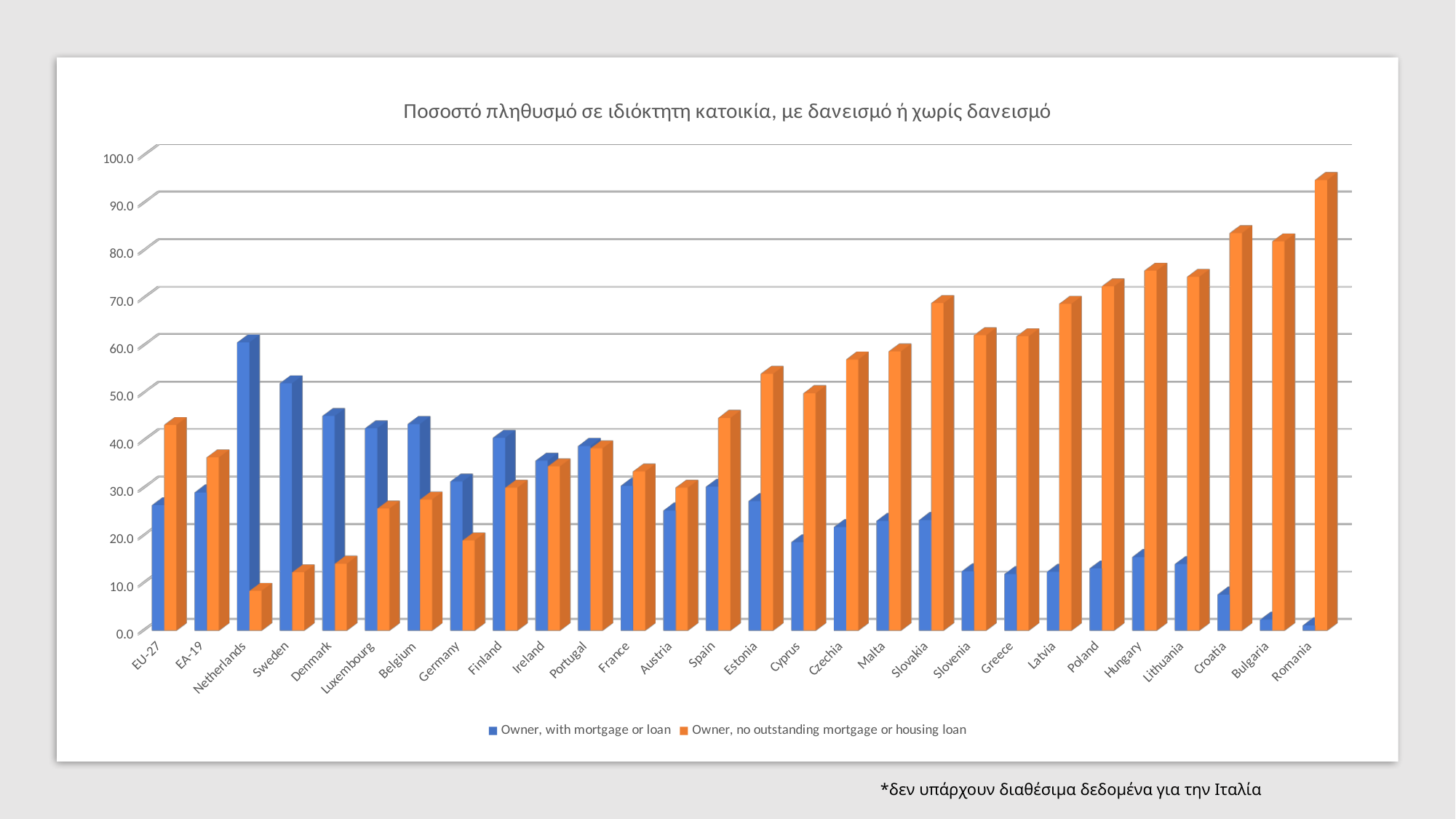
Which colour represents the 'Owner, no outstanding mortgage or housing loan' series? orange How many series does the legend list? 2 Is the value for Romania in the 'Owner, no outstanding mortgage or housing loan' series greater or less than 90? greater Which category has the highest value for 'Owner, no outstanding mortgage or housing loan'? Romania Which category has the lowest value for 'Owner, no outstanding mortgage or housing loan'? Netherlands How many countries/categories are shown on the x axis? 28 Is the value for Sweden in the 'Owner, with mortgage or loan' series greater or less than 50? greater Which category has the lowest value for 'Owner, with mortgage or loan'? Romania For the Netherlands, which series has the larger value: 'Owner, with mortgage or loan' or 'Owner, no outstanding mortgage or housing loan'? Owner, with mortgage or loan Which category has the highest value for 'Owner, with mortgage or loan'? Netherlands What kind of chart is shown on the slide? bar chart